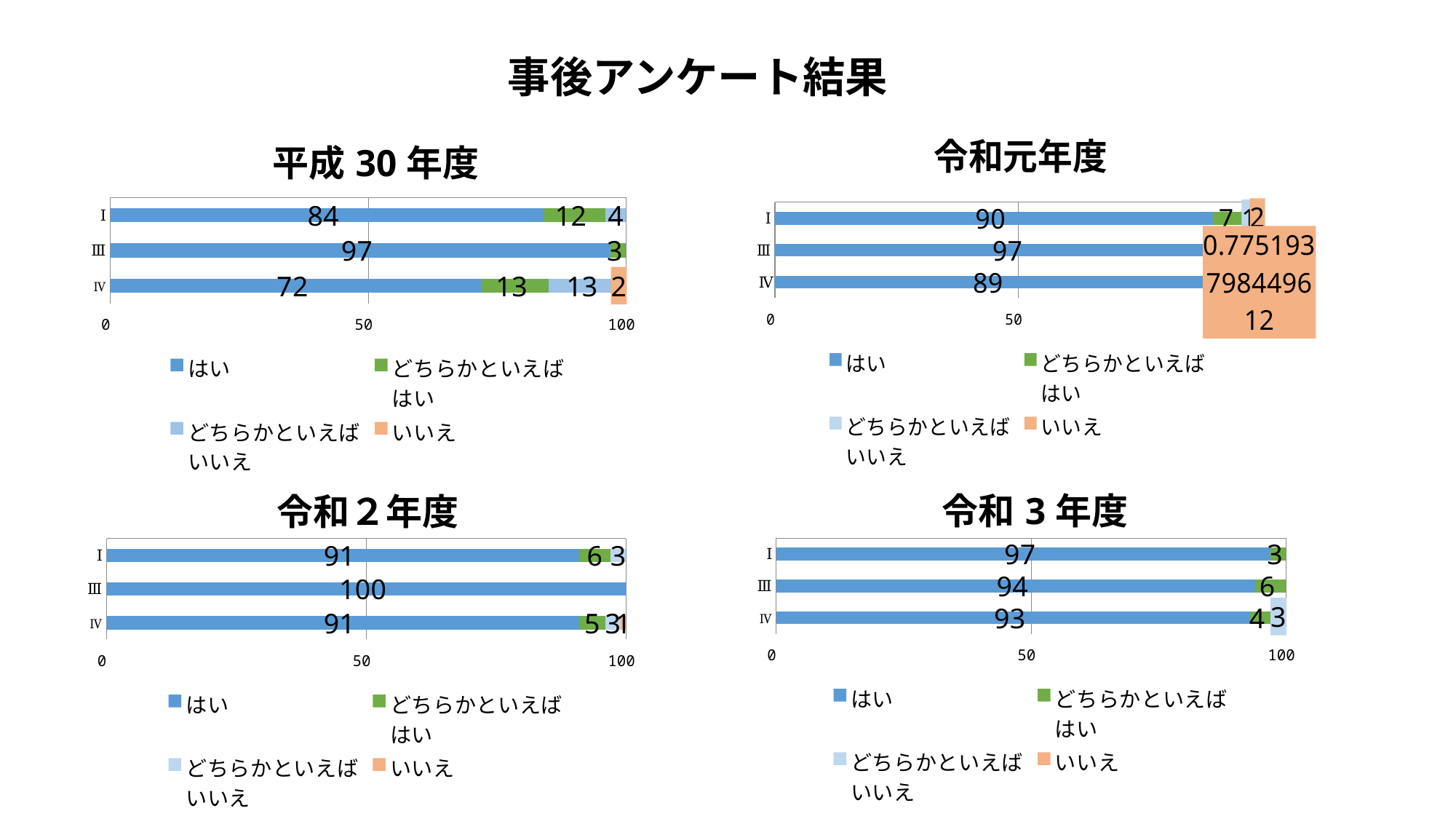
In the 平成30年度 chart, what is the value of はい for category Ⅳ? 72 In the 平成30年度 chart, which category has the highest はい value? Ⅲ In the 令和元年度 chart, what is the value of はい for category I? 90 What kind of chart is the 令和2年度 chart? Stacked bar chart In the 令和3年度 chart, which category has the lowest はい value? Ⅳ In the 令和2年度 chart, what is the value of はい for category Ⅲ? 100 In the 平成30年度 chart, what is the value of どちらかといえばはい for category I? 12 How many series does the legend of the 令和3年度 chart list? 4 In the 令和元年度 chart, which category has the lowest はい value? Ⅳ In the 令和3年度 chart, is the はい value for category I larger than the はい value for category Ⅲ? Yes In the 令和2年度 chart, what is the value of どちらかといえばはい for category Ⅳ? 5 In the 平成30年度 chart, what is the difference between the はい values for Ⅲ and Ⅳ? 25